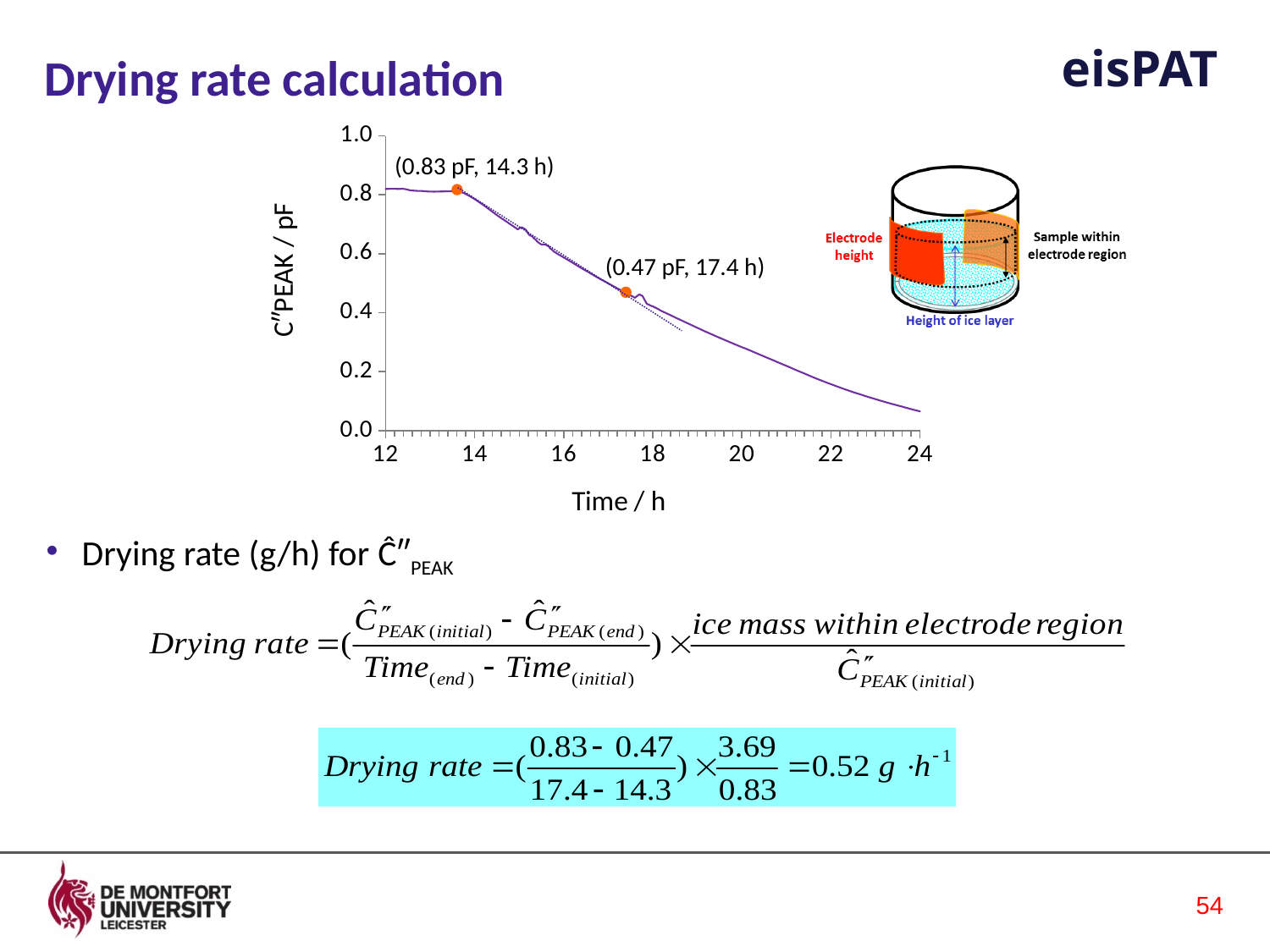
Is the C''PEAK value at 20 h greater or less than 0.4 pF? less At what time does the labelled point with C''PEAK = 0.47 pF occur? 17.4 h What is the difference in C''PEAK between the two labelled points (0.83 pF and 0.47 pF)? 0.36 pF What is the C''PEAK value at the second labelled point on the curve, at 17.4 h? 0.47 pF How many hours separate the two labelled points on the curve (14.3 h and 17.4 h)? 3.1 h What kind of chart is shown on the slide? line chart Is the C''PEAK value at 24 h greater or less than 0.2 pF? less At what time does the labelled point with C''PEAK = 0.83 pF occur? 14.3 h Does C''PEAK rise or fall as time increases from 12 h to 24 h? fall Which labelled point has the larger C''PEAK value, the one at 14.3 h or the one at 17.4 h? 14.3 h What is the title of the x axis of the chart? Time / h What is the C''PEAK value at the first labelled point on the curve, at 14.3 h? 0.83 pF